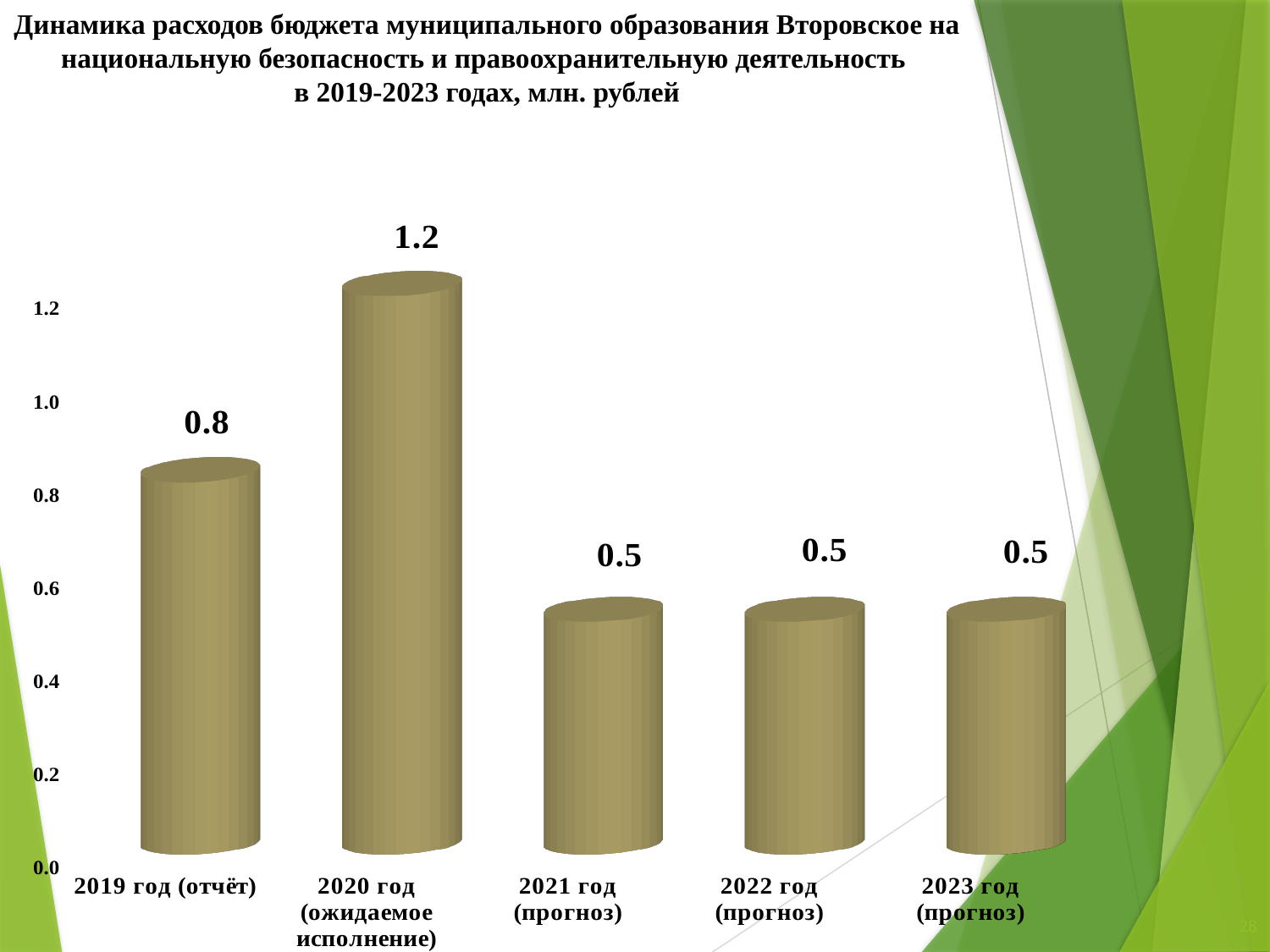
What is the value for 2019 год (отчёт)? 0.8 Which year has the highest value? 2020 год (ожидаемое исполнение) Is the value for 2020 год greater or less than 1.0? greater What is the difference between the values for 2020 год and 2019 год? 0.4 What is the difference between the values for 2019 год and 2021 год? 0.3 In what units are the values on the chart expressed, according to the title? млн. рублей What is the value for 2020 год (ожидаемое исполнение)? 1.2 What is the value for 2022 год (прогноз)? 0.5 How many categories (years) are shown on the chart? 5 Which is larger, the value for 2019 год (отчёт) or the value for 2023 год (прогноз)? 2019 год (отчёт) Do the values rise or fall from 2020 год to 2021 год? fall What kind of chart is shown on the slide? bar chart